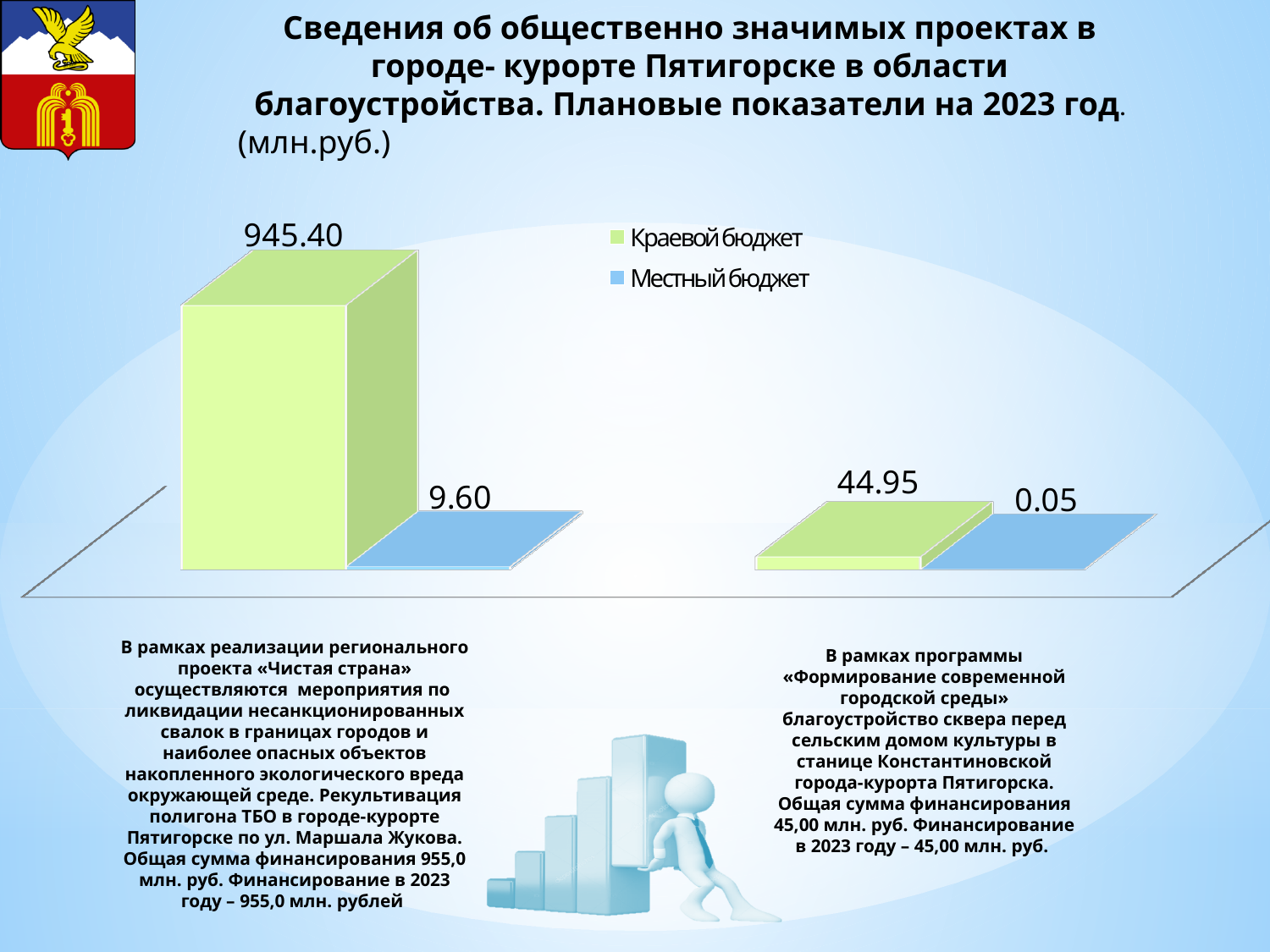
How many series does the chart legend list? 2 Which bar in the chart has the lowest value? Местный бюджет in the right group (0.05) Which is larger: the Местный бюджет value in the left group or the Краевой бюджет value in the right group? Краевой бюджет in the right group (44.95) What is the total of the Краевой бюджет and Местный бюджет values in the right group? 45.00 What is the value of the Местный бюджет bar in the left group of the chart? 9.60 What is the value of the Краевой бюджет bar in the right group of the chart? 44.95 What is the difference between the Краевой бюджет and Местный бюджет values in the left group? 935.80 What kind of chart is shown on the slide? bar chart What are the two series named in the chart legend? Краевой бюджет, Местный бюджет What is the value of the Краевой бюджет bar in the left group of the chart? 945.40 What is the value of the Местный бюджет bar in the right group of the chart? 0.05 Which bar in the chart has the highest value? Краевой бюджет in the left group (945.40)